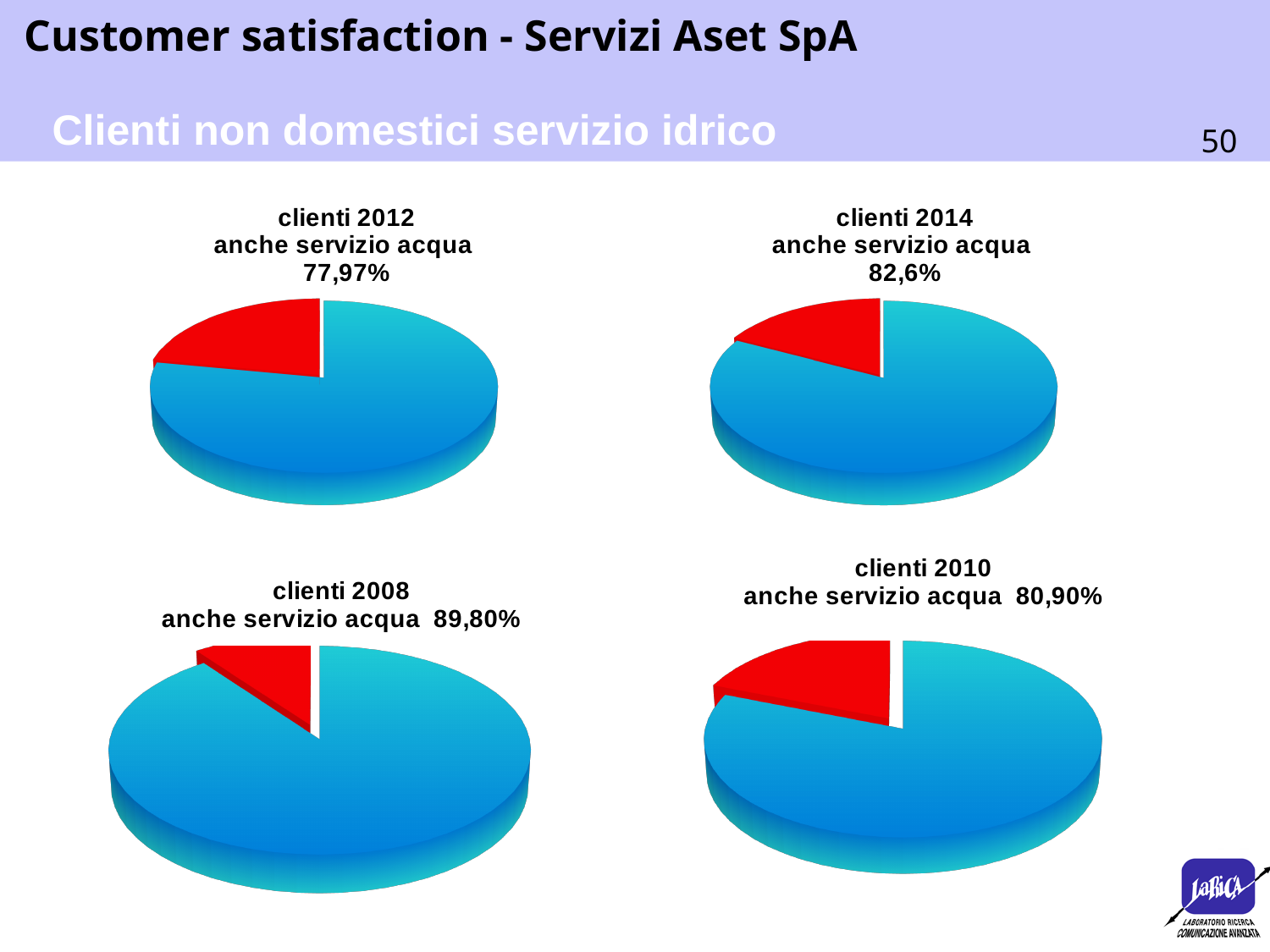
What is the difference between the percentage in the 'clienti 2014' chart title and the percentage in the 'clienti 2012' chart title? 4,63% Across the four pie charts, which year's chart shows the highest 'anche servizio acqua' percentage? clienti 2008 What type of chart is used for 'clienti 2012'? Pie chart Across the four pie charts, which year's chart shows the lowest 'anche servizio acqua' percentage? clienti 2012 What is the difference between the percentage in the 'clienti 2008' chart title and the percentage in the 'clienti 2010' chart title? 8,90% How many slices does the 'clienti 2008' pie chart have? 2 In the 'clienti 2014' pie chart, what colour is the larger slice? Blue What percentage is shown in the title of the 'clienti 2008' pie chart? 89,80% Which is larger: the percentage in the 'clienti 2014' chart title or the percentage in the 'clienti 2010' chart title? clienti 2014 What percentage is shown in the title of the 'clienti 2014' pie chart? 82,6% What percentage is shown in the title of the 'clienti 2012' pie chart? 77,97% What percentage is shown in the title of the 'clienti 2010' pie chart? 80,90%